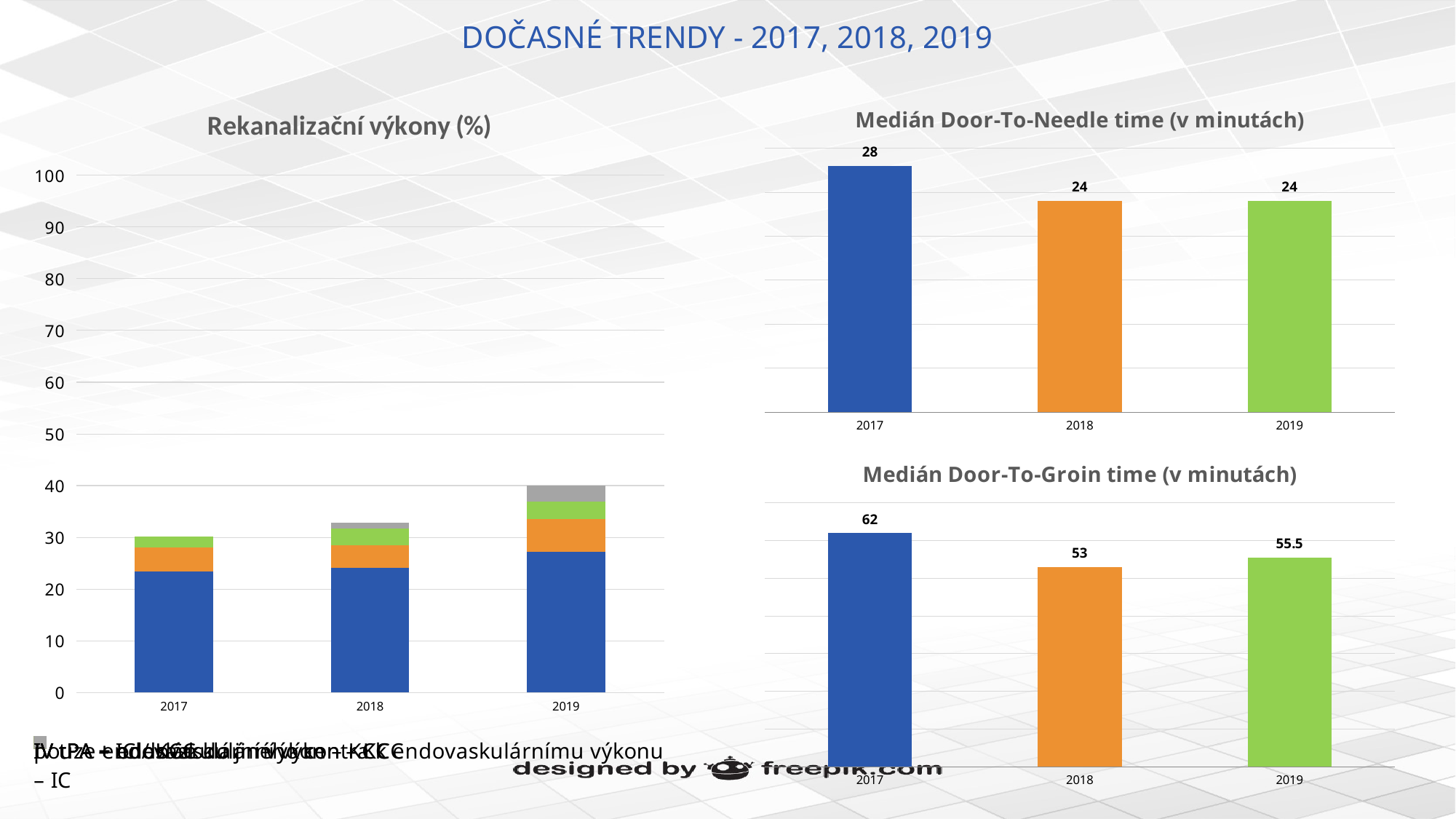
In the Medián Door-To-Needle time (v minutách) chart, what is the value for 2017? 28 How many years are shown in the Medián Door-To-Needle time (v minutách) chart? 3 In the Medián Door-To-Groin time (v minutách) chart, what is the value for 2019? 55.5 In the Medián Door-To-Needle time (v minutách) chart, what is the difference between the values for 2017 and 2018? 4 In the Rekanalizační výkony (%) chart, is the total stacked value for 2019 greater or less than 30? greater In the Medián Door-To-Needle time (v minutách) chart, what is the value for 2018? 24 In the Medián Door-To-Groin time (v minutách) chart, which year has the lowest value? 2018 In the Medián Door-To-Groin time (v minutách) chart, what is the difference between the values for 2017 and 2019? 6.5 What kind of chart is the Medián Door-To-Groin time (v minutách) chart? bar chart In the Medián Door-To-Needle time (v minutách) chart, which year has the highest value? 2017 In the Medián Door-To-Groin time (v minutách) chart, which is larger, the value for 2018 or 2019? 2019 In the Rekanalizační výkony (%) chart, do the total stacked values rise or fall from 2017 to 2019? rise